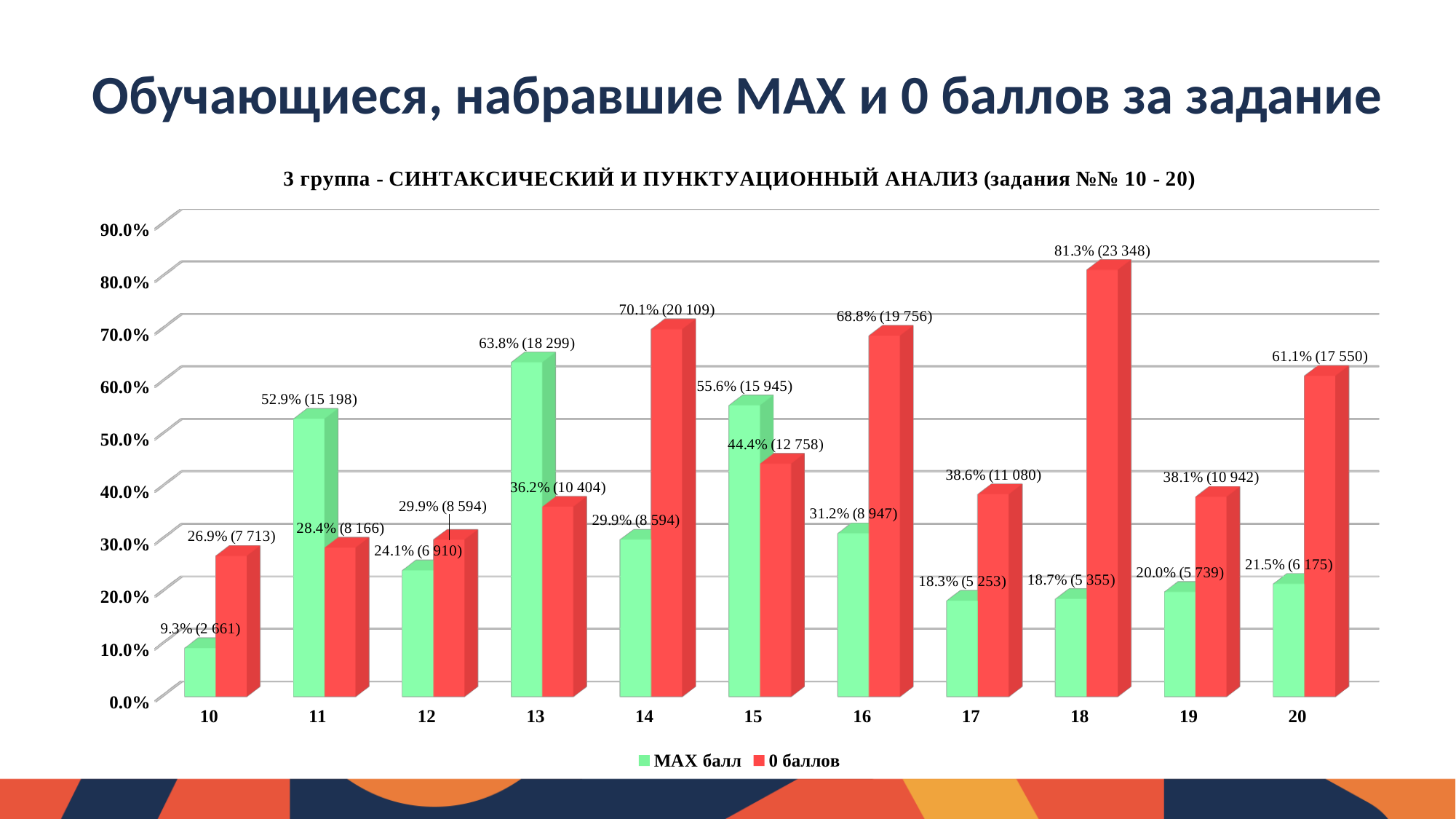
What is the value for task 15 in the 0 баллов series? 44.4% (12 758) Which task has the highest value in the MAX балл series? 13 What is the value for task 18 in the 0 баллов series? 81.3% (23 348) What is the value for task 10 in the MAX балл series? 9.3% (2 661) What is the value for task 13 in the MAX балл series? 63.8% (18 299) How many series does the legend list? 2 Which task has the lowest value in the MAX балл series? 10 For task 11, which series has the larger value, MAX балл or 0 баллов? MAX балл How many tasks are shown on the x axis? 11 What is the difference in percentage points between the 0 баллов and MAX балл values for task 14? 40.2 Which task has the highest value in the 0 баллов series? 18 What kind of chart is shown on the slide? Bar chart